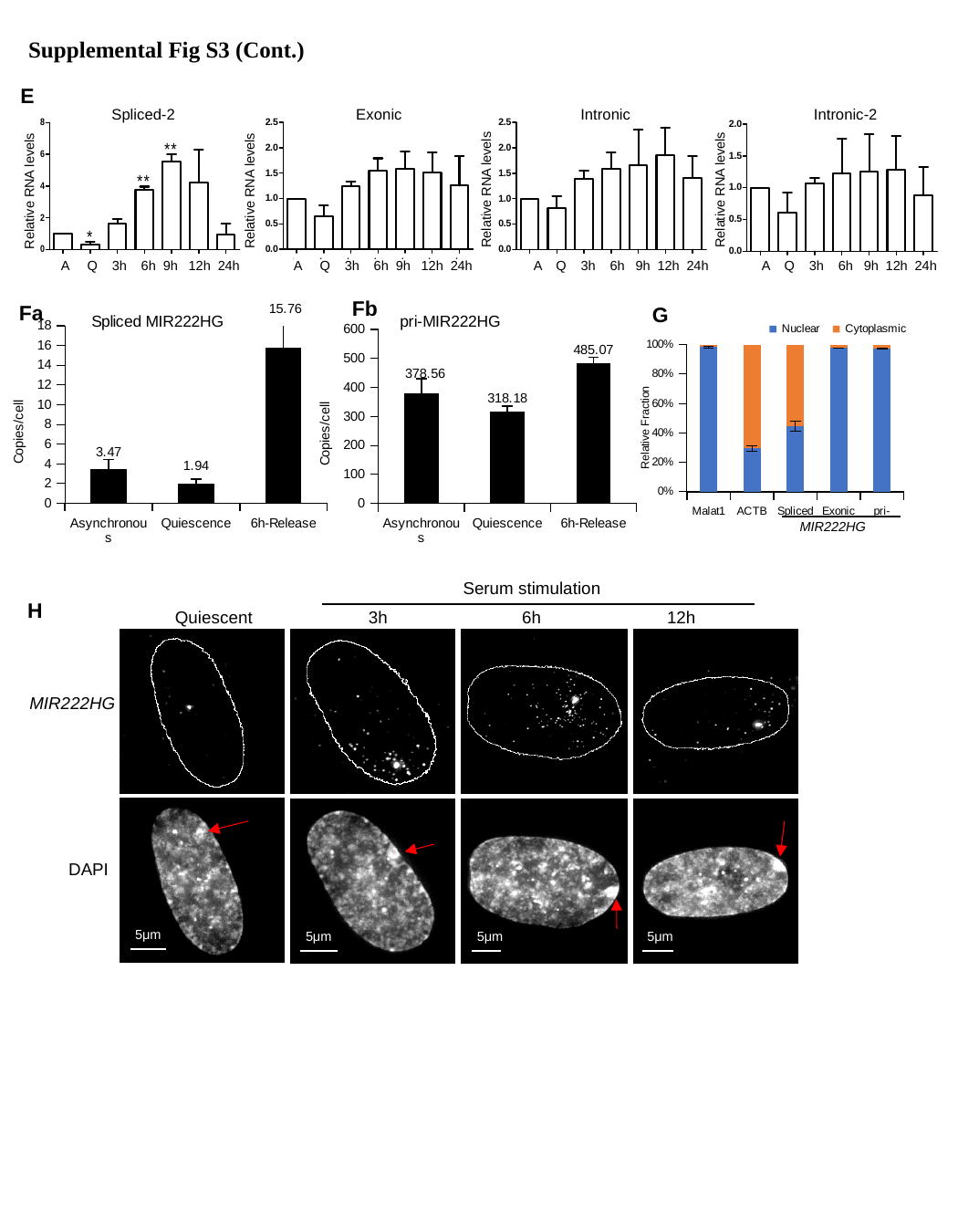
In the pri-MIR222HG chart (Fb), what is the value for Asynchronous? 378.56 In the Spliced MIR222HG chart (Fa), what is the value for Quiescence? 1.94 In the Spliced MIR222HG chart (Fa), what is the value for 6h-Release? 15.76 In the pri-MIR222HG chart (Fb), which category has the lowest value? Quiescence In the pri-MIR222HG chart (Fb), what is the difference between the 6h-Release value and the Quiescence value? 166.89 In the Spliced-2 chart (panel E), is the value for 9h greater or less than 4? greater How many categories are shown on the x axis of the Exonic chart in panel E? 7 In the pri-MIR222HG chart (Fb), which category has the highest value? 6h-Release In chart G, which category has the largest Cytoplasmic fraction? ACTB In the Spliced MIR222HG chart (Fa), which is larger, the value for Asynchronous or the value for Quiescence? Asynchronous How many series does the legend of chart G list? 2 In the Spliced MIR222HG chart (Fa), what is the difference between the 6h-Release value and the Asynchronous value? 12.29